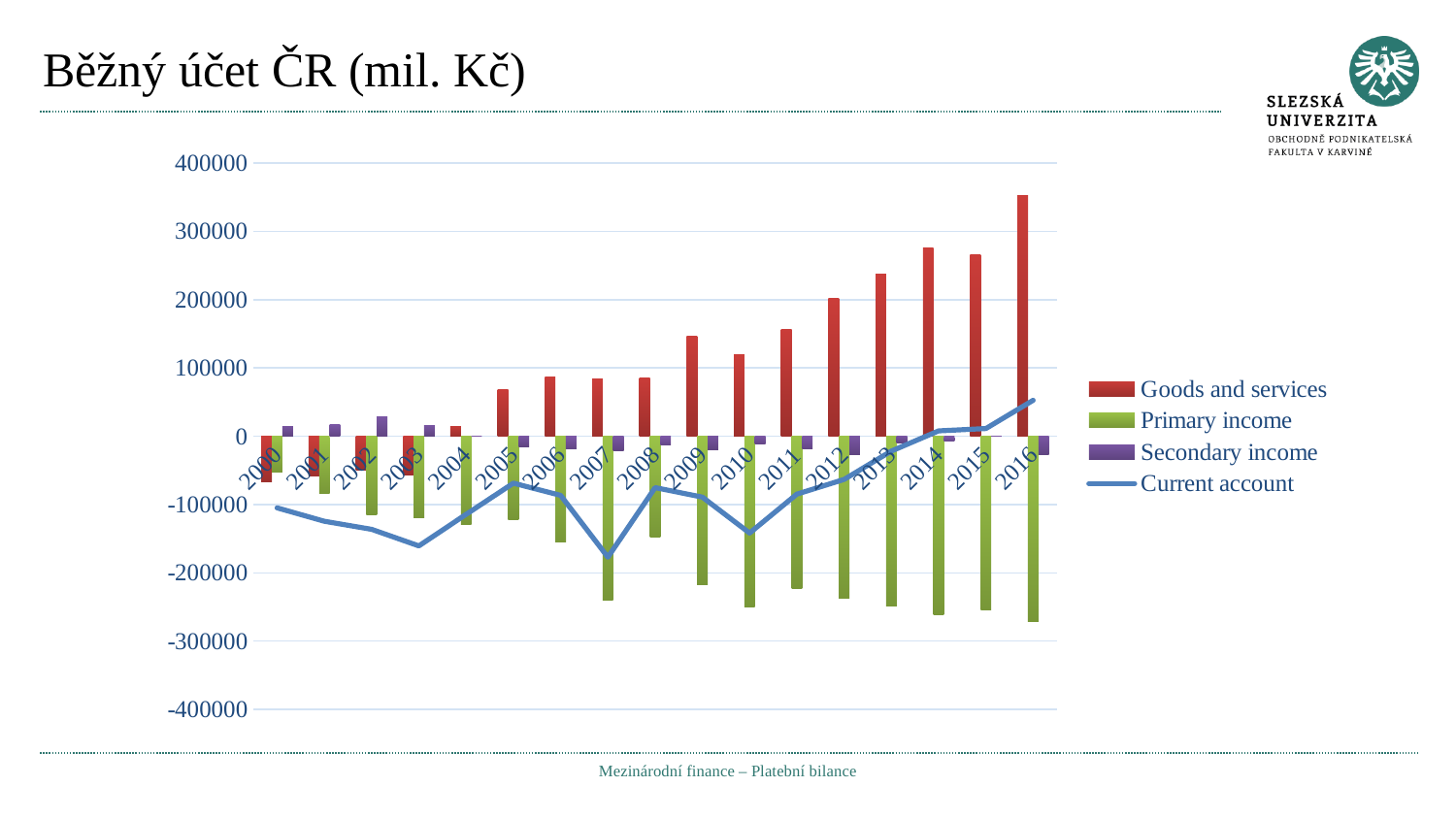
Is the Goods and services value for 2000 greater or less than 0? less Is the Current account value for 2007 greater or less than -100000? less In which year is the Goods and services value highest? 2016 What kind of chart is this? Combined bar and line chart Is the Primary income value for 2016 greater or less than -200000? less How many series does the legend list? 4 In which year does the Current account line reach its lowest point? 2007 How many years are shown on the x axis? 17 Which is larger, the Goods and services value for 2015 or for 2016? 2016 In which year is the Primary income value lowest? 2016 What is the title of the chart? Běžný účet ČR (mil. Kč)